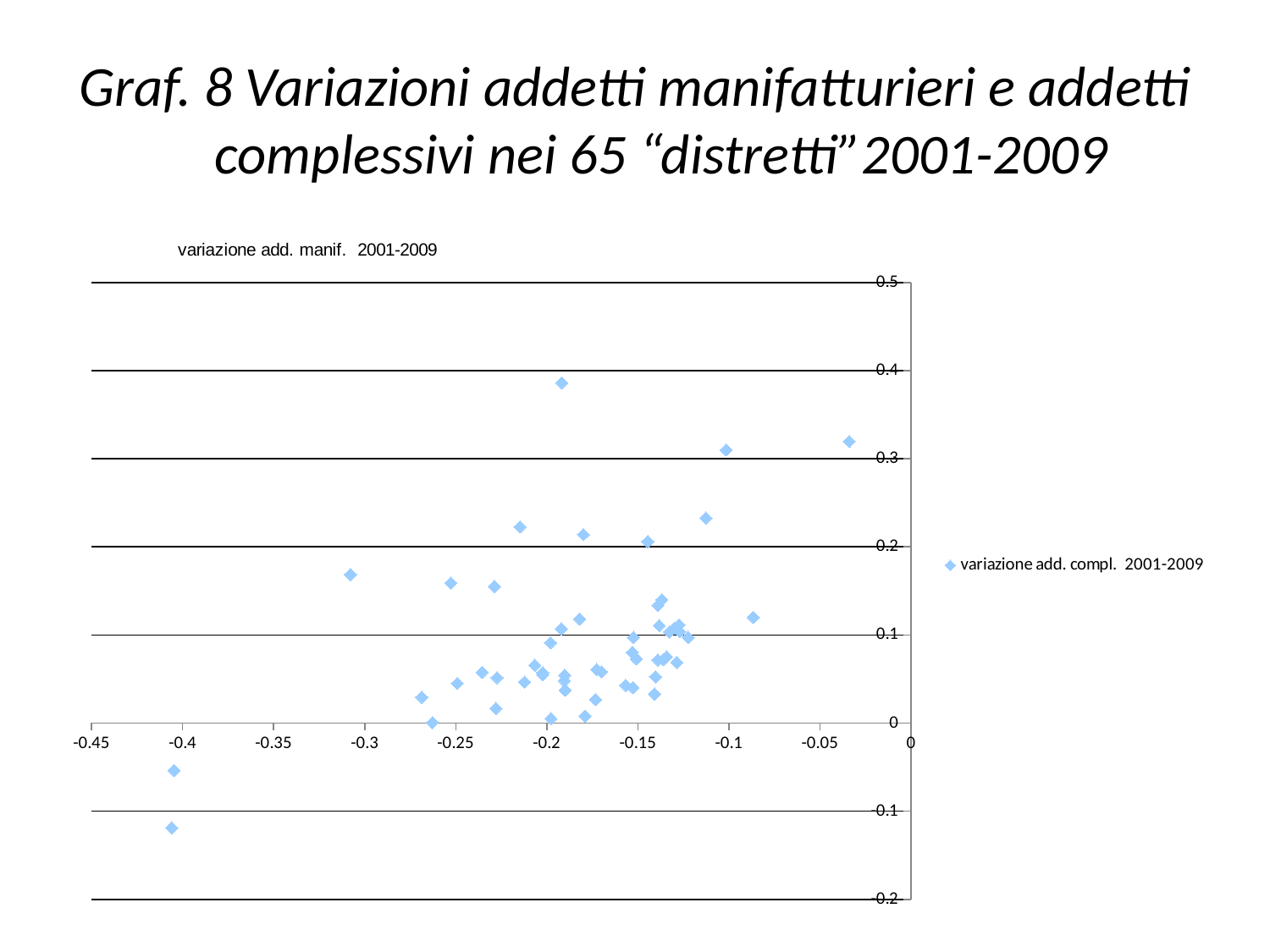
Is the y value of the highest point on the chart greater or less than 0.3? greater What label is shown above the chart for the horizontal axis variable? variazione add. manif. 2001-2009 What kind of chart is shown on the slide? scatter chart How many points have a y value above 0.35? 1 What is the legend entry for the plotted series? variazione add. compl. 2001-2009 Is the y value of the rightmost point (near x = -0.05) greater or less than 0.2? greater Is the y value of the lowest point on the chart greater or less than 0? less How many series does the legend list? 1 How many points have a y value below 0? 2